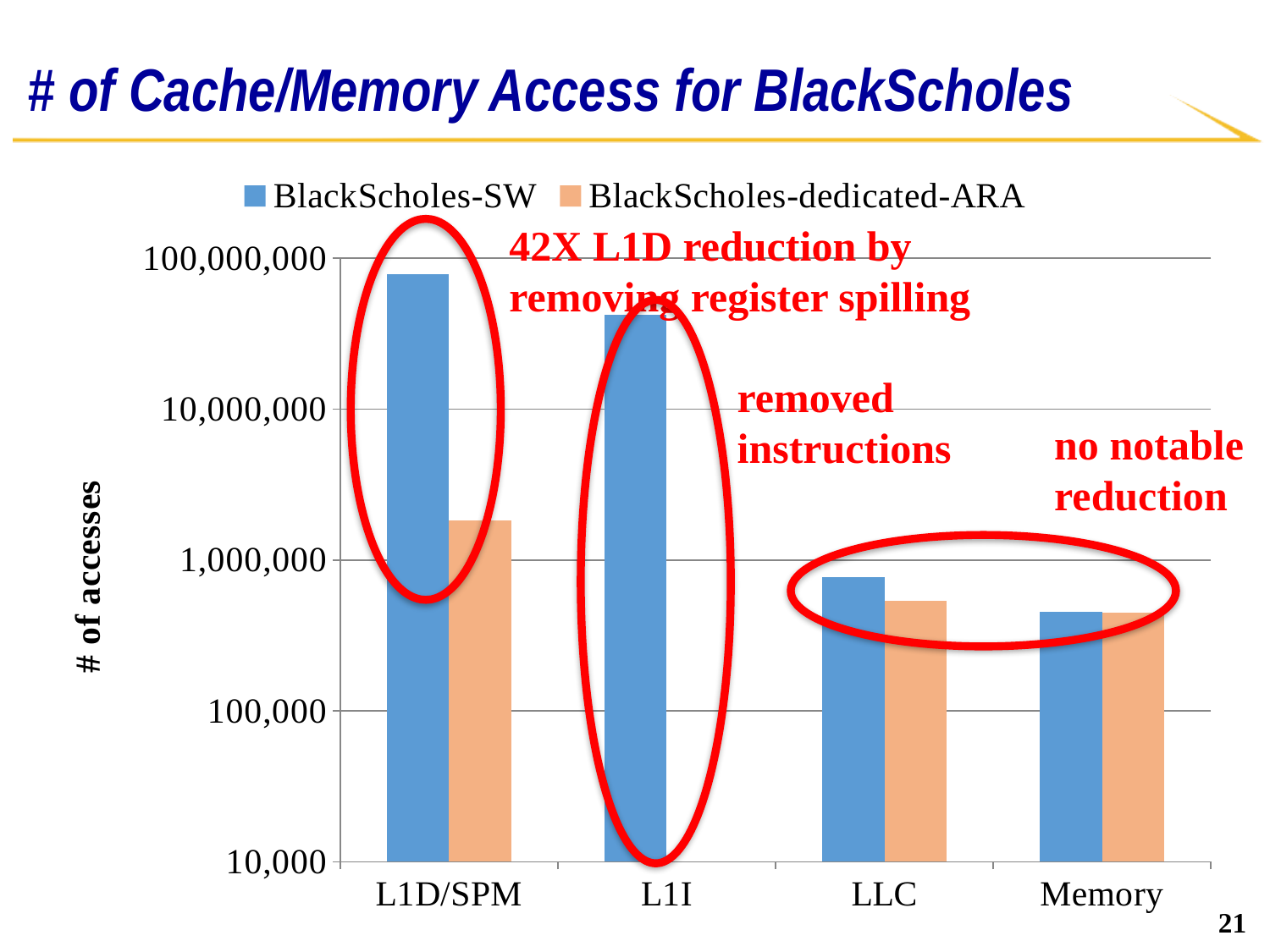
Do the BlackScholes-SW values rise or fall from L1D/SPM to Memory along the x axis? fall Which category has the highest value for BlackScholes-dedicated-ARA? L1D/SPM Which category has the lowest value for BlackScholes-SW? Memory Which category has the highest value for BlackScholes-SW? L1D/SPM What kind of chart is shown on the slide? bar chart Is the BlackScholes-SW value for LLC greater or less than 1,000,000? less For L1D/SPM, which series has the larger value, BlackScholes-SW or BlackScholes-dedicated-ARA? BlackScholes-SW Is the BlackScholes-SW value for L1D/SPM greater or less than 10,000,000? greater How many series does the legend list? 2 Is the BlackScholes-dedicated-ARA value for L1D/SPM greater or less than 1,000,000? greater How many categories are shown on the x axis? 4 What is the label of the y axis? # of accesses